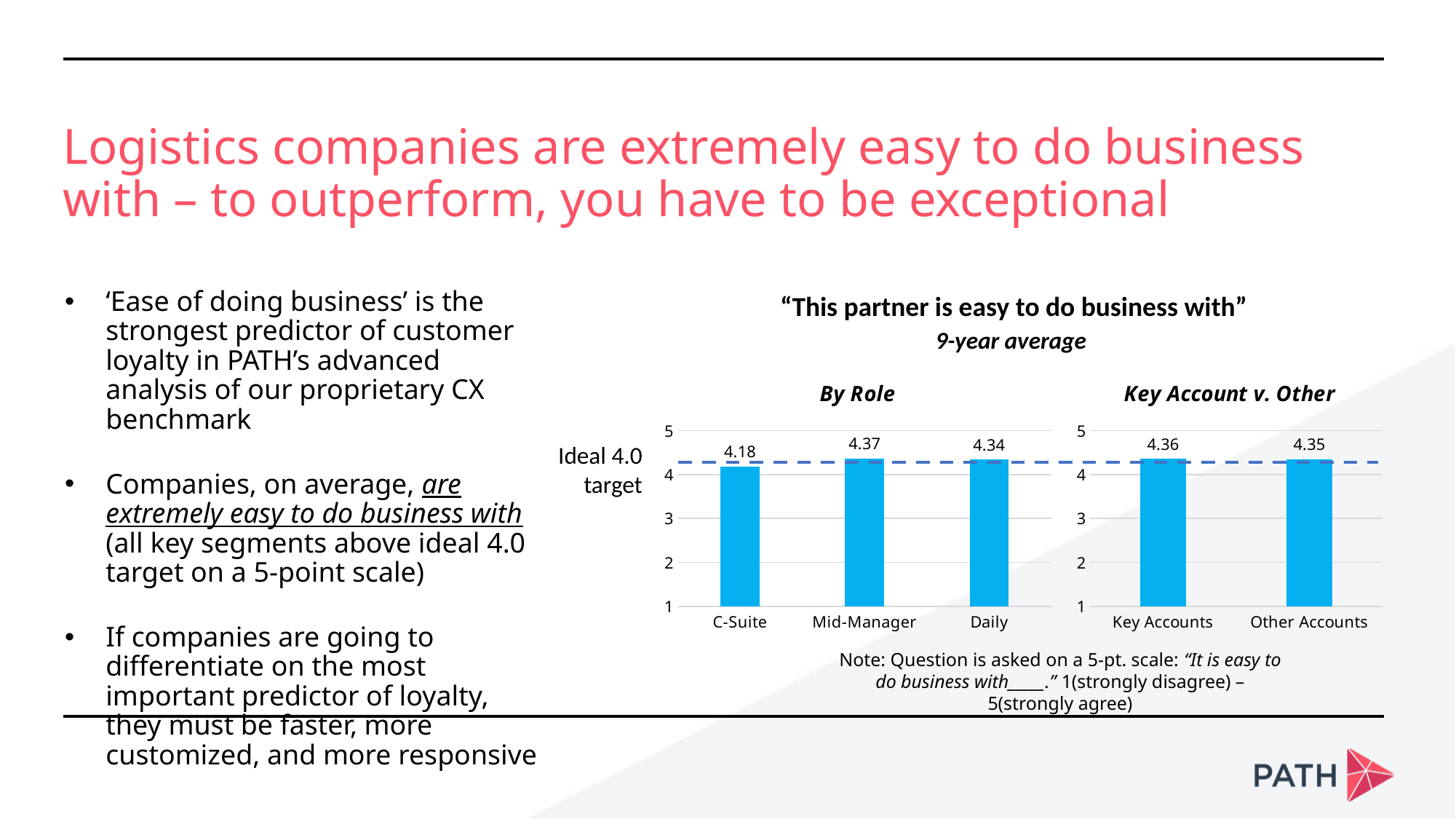
What does the dashed horizontal line across both charts represent? Ideal 4.0 target In the "Key Account v. Other" chart, what is the value for Other Accounts? 4.35 In the "By Role" chart, which role has the lowest value? C-Suite In the "Key Account v. Other" chart, what is the value for Key Accounts? 4.36 In the "By Role" chart, what is the difference between the Mid-Manager and C-Suite values? 0.19 In the "By Role" chart, is the value for C-Suite greater or less than 4? greater In the "By Role" chart, what is the value for C-Suite? 4.18 In the "By Role" chart, what is the value for Mid-Manager? 4.37 What kind of chart is the "Key Account v. Other" chart? Bar chart How many categories are shown in the "By Role" chart? 3 In the "By Role" chart, which role has the highest value? Mid-Manager In the "By Role" chart, what is the value for Daily? 4.34